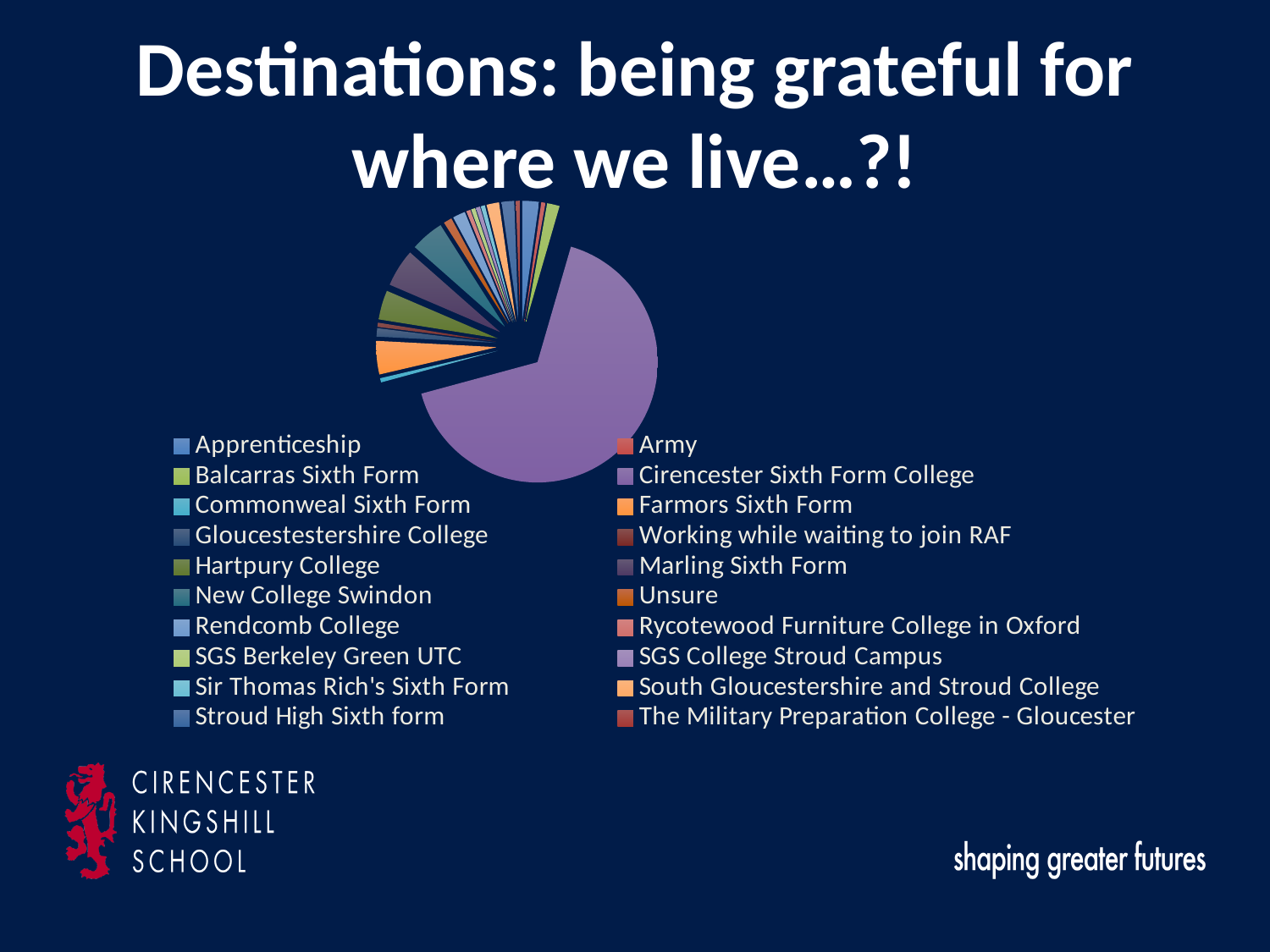
How many destination categories does the legend of the pie chart list? 20 Does the slice for Cirencester Sixth Form College take up more or less than half of the pie chart? more What kind of chart is shown on the slide? pie chart Which legend entry in the pie chart refers to the RAF? Working while waiting to join RAF What is the title of the slide containing the pie chart? Destinations: being grateful for where we live...?! Which destination has the largest slice of the pie chart? Cirencester Sixth Form College Which is larger in the pie chart: the slice for Cirencester Sixth Form College or the slice for Farmors Sixth Form? Cirencester Sixth Form College